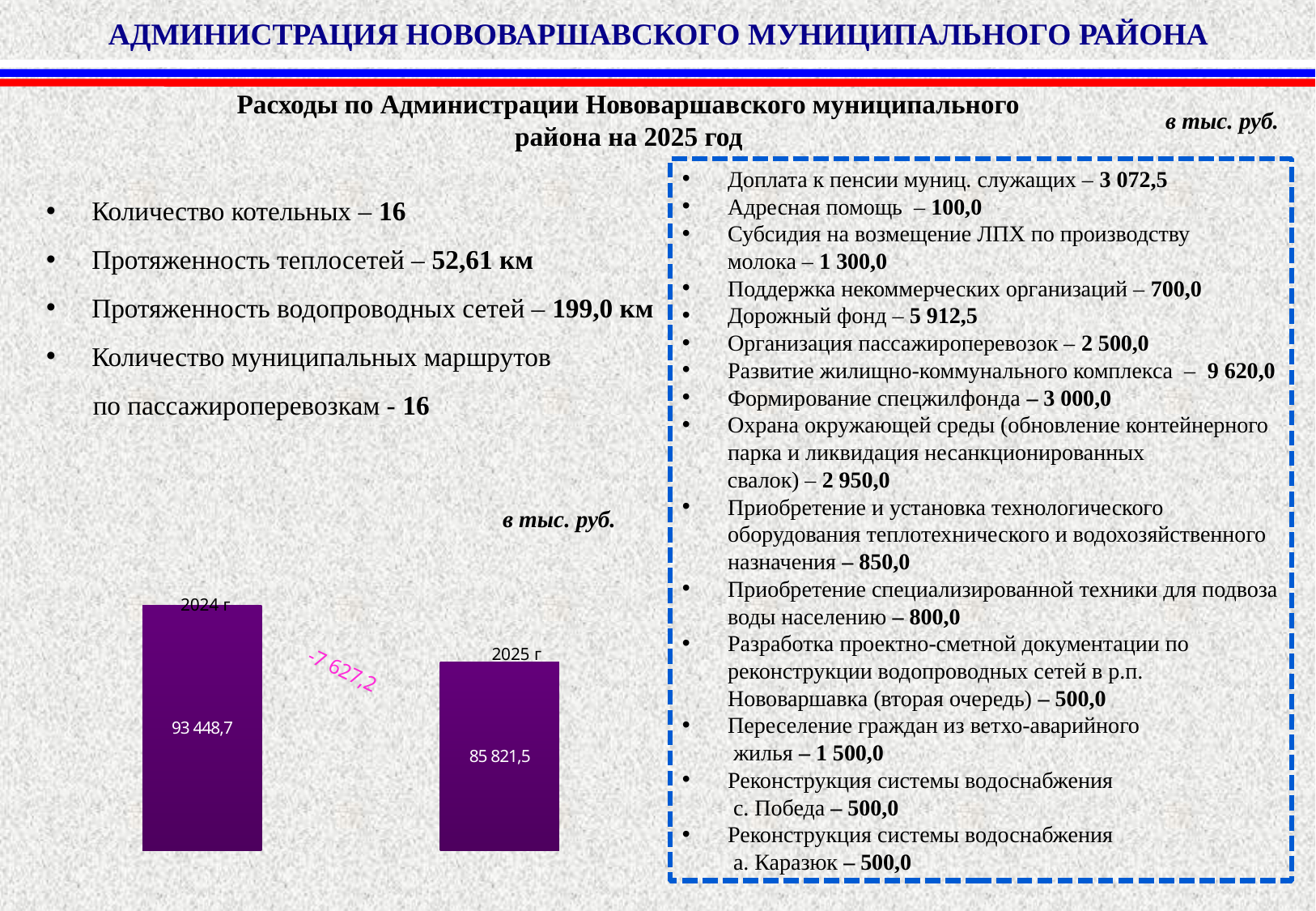
Which category has the highest value in the chart? 2024 г Which category has the lowest value in the chart? 2025 г Which year has the higher bar in the chart, 2024 г or 2025 г? 2024 г What is the value shown for the 2025 г bar in the chart? 85 821,5 Do the values in the chart rise or fall from 2024 г to 2025 г? fall What is the value shown for the 2024 г bar in the chart? 93 448,7 What type of chart is shown on the slide? bar chart In what units are the values in the chart expressed, according to the label above it? в тыс. руб. What is the difference between the 2024 г and 2025 г values in the chart? 7 627,2 What change value is annotated between the two bars in the chart? -7 627,2 How many bars are plotted in the chart? 2